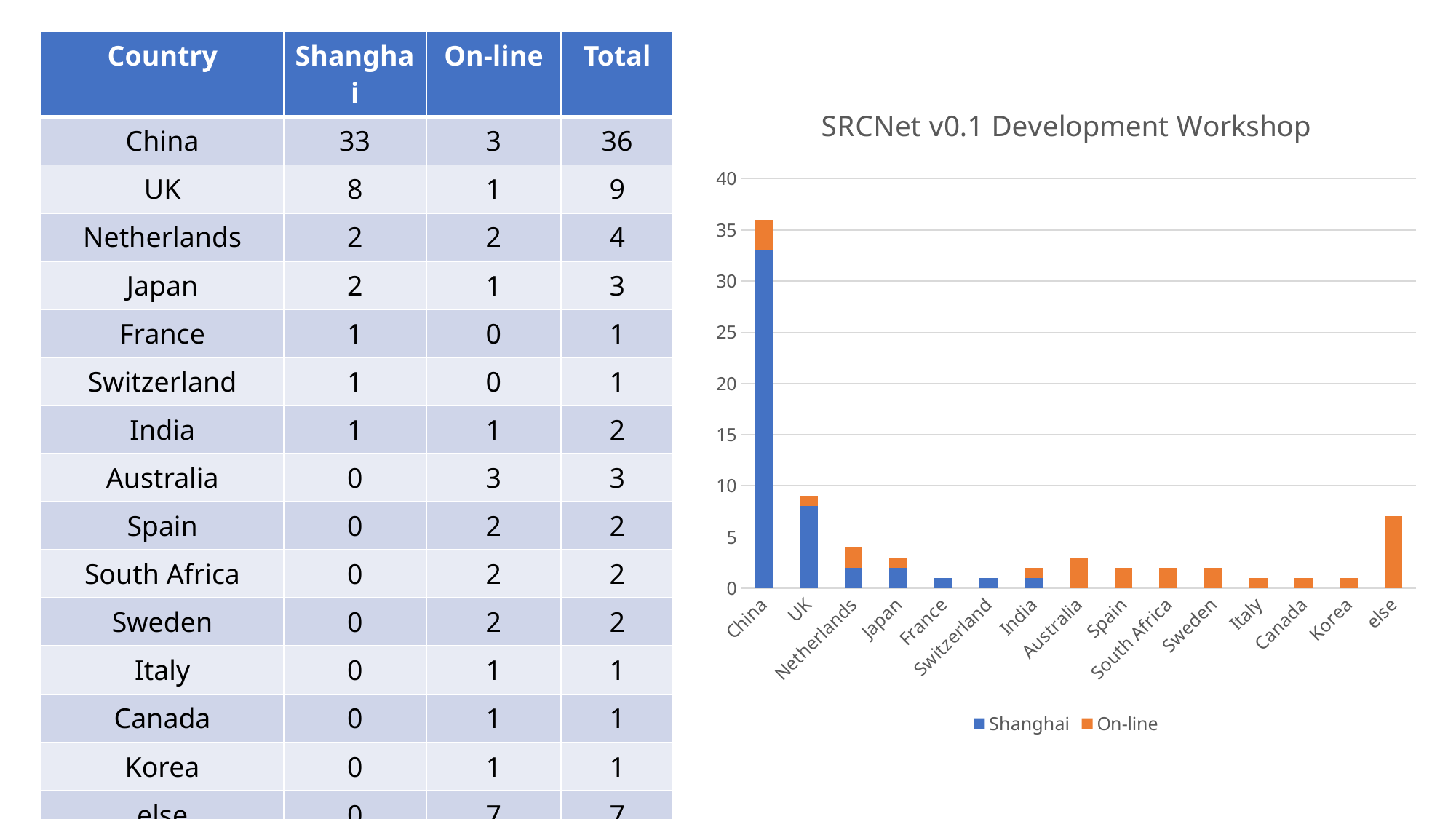
What is the difference between the total for China and the total for UK? 27 Which has a larger total, UK or Netherlands? UK What kind of chart is shown on the slide? bar chart How many countries/categories are shown along the x axis of the chart? 15 What is the On-line value for Australia? 3 What is the total height of the stacked bar for China? 36 Is the total value for China greater or less than 30? greater What is the title of the chart? SRCNet v0.1 Development Workshop What is the Shanghai value for China? 33 Is the total value for UK greater or less than 10? less Which category has the tallest bar in the chart? China How many series does the chart legend list? 2